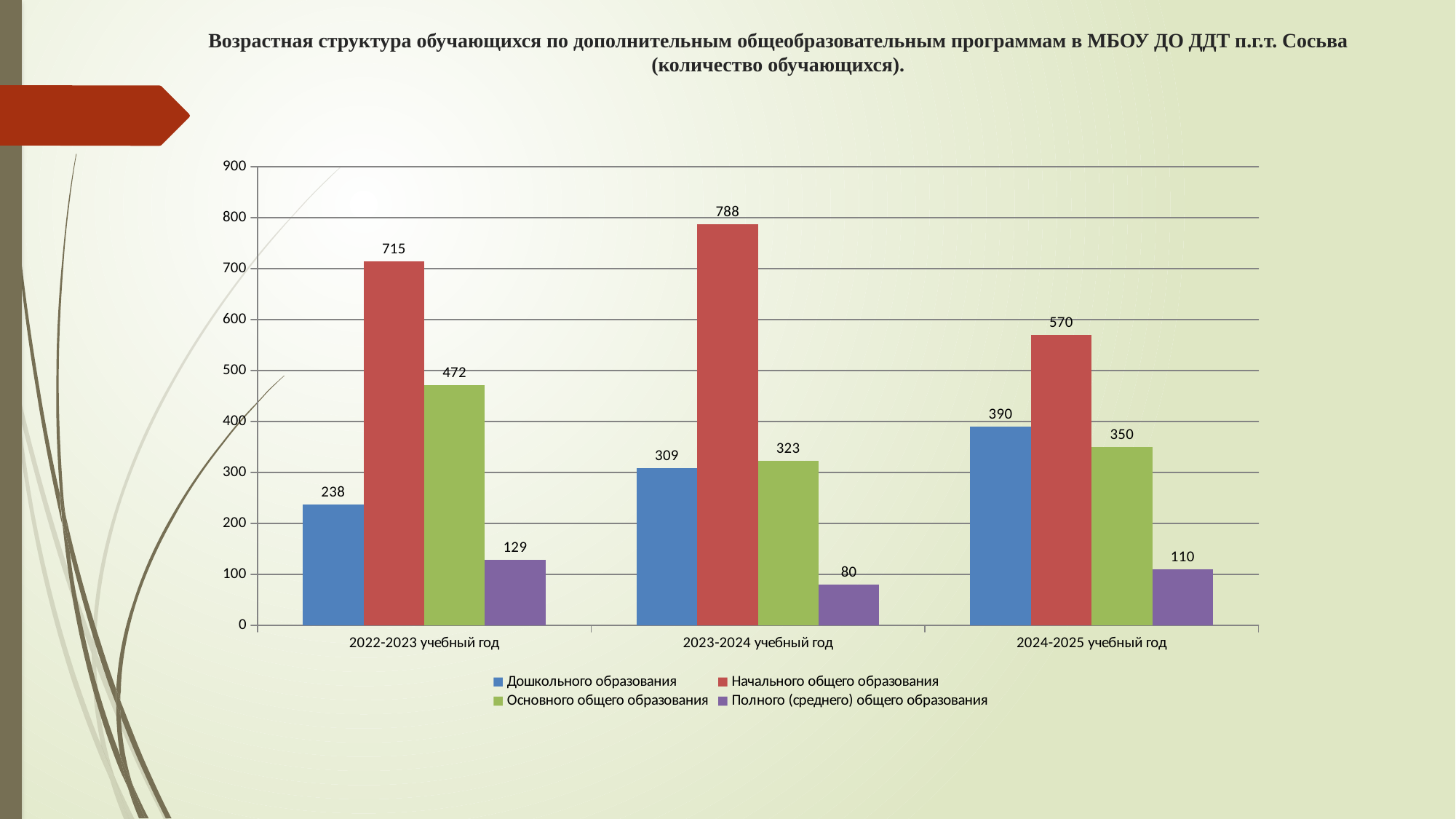
How many series does the legend list? 4 What is the value for Начального общего образования in 2023-2024 учебный год? 788 How many school years are shown on the x axis? 3 Is the value for Дошкольного образования in 2023-2024 учебный год greater or less than 300? greater What is the value for Дошкольного образования in 2022-2023 учебный год? 238 Which is larger in 2022-2023 учебный год: Основного общего образования or Дошкольного образования? Основного общего образования In which school year is the value for Начального общего образования highest? 2023-2024 учебный год What is the value for Полного (среднего) общего образования in 2024-2025 учебный год? 110 Does the value for Дошкольного образования rise or fall across the school years from 2022-2023 to 2024-2025? rise In which school year is the value for Полного (среднего) общего образования lowest? 2023-2024 учебный год What is the difference between Начального общего образования and Основного общего образования in 2024-2025 учебный год? 220 What kind of chart is shown on the slide? bar chart